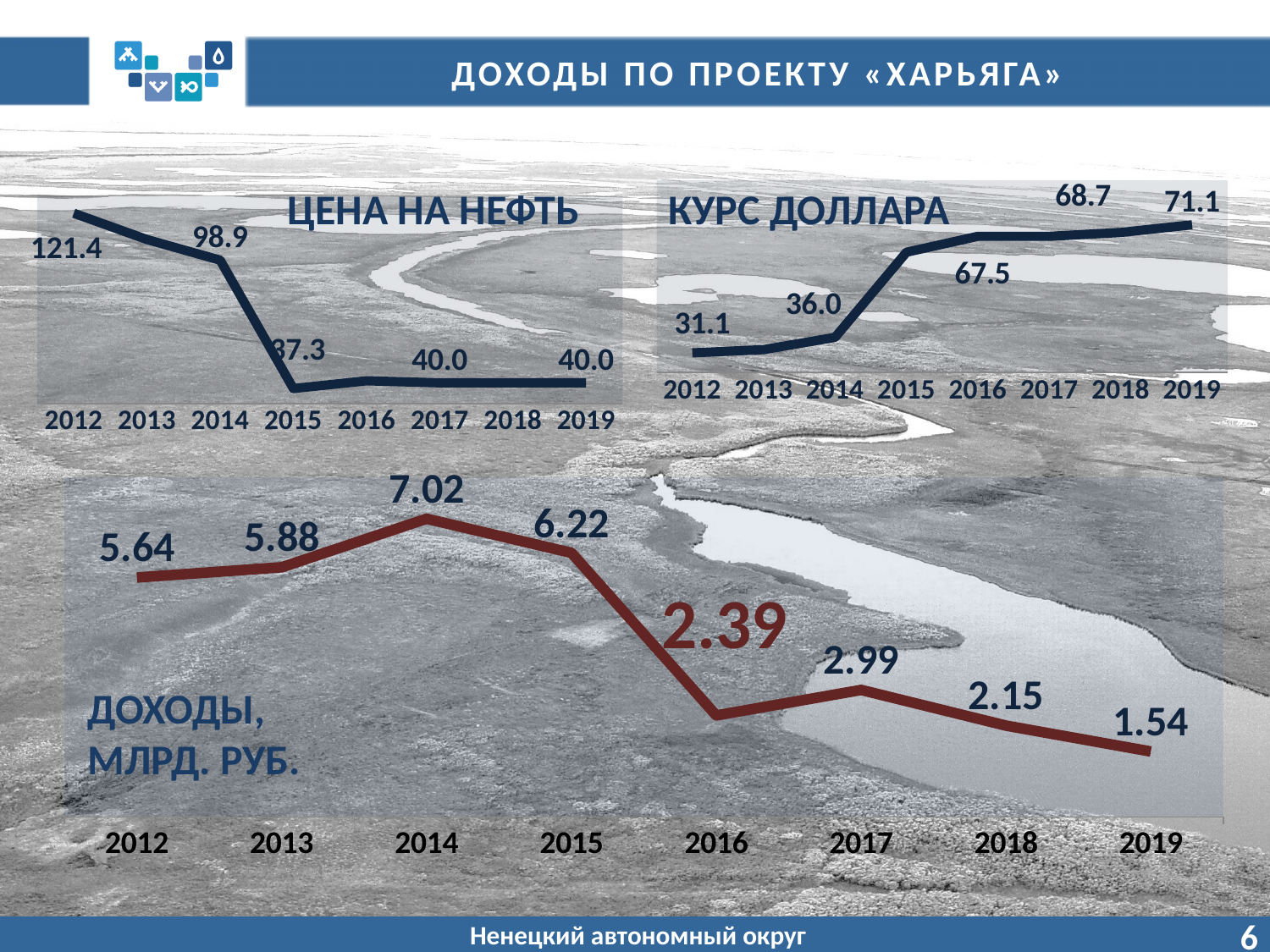
On the 'ДОХОДЫ, МЛРД. РУБ.' chart, what is the value for 2019? 1.54 What kind of chart is the 'ЦЕНА НА НЕФТЬ' chart? line chart On the 'КУРС ДОЛЛАРА' chart, do the values rise or fall from 2012 to 2019? rise How many years are shown on the x axis of the 'ДОХОДЫ, МЛРД. РУБ.' chart? 8 On the 'ДОХОДЫ, МЛРД. РУБ.' chart, what is the value for 2014? 7.02 On the 'ДОХОДЫ, МЛРД. РУБ.' chart, which year has the highest value? 2014 On the 'ДОХОДЫ, МЛРД. РУБ.' chart, which year has the lowest value? 2019 On the 'ДОХОДЫ, МЛРД. РУБ.' chart, what is the difference between the 2014 and 2015 values? 0.80 On the 'ЦЕНА НА НЕФТЬ' chart, what is the value for 2012? 121.4 On the 'ДОХОДЫ, МЛРД. РУБ.' chart, which is larger, the value for 2017 or the value for 2018? 2017 On the 'ЦЕНА НА НЕФТЬ' chart, what is the value for 2015? 37.3 On the 'ДОХОДЫ, МЛРД. РУБ.' chart, what is the value for 2016? 2.39